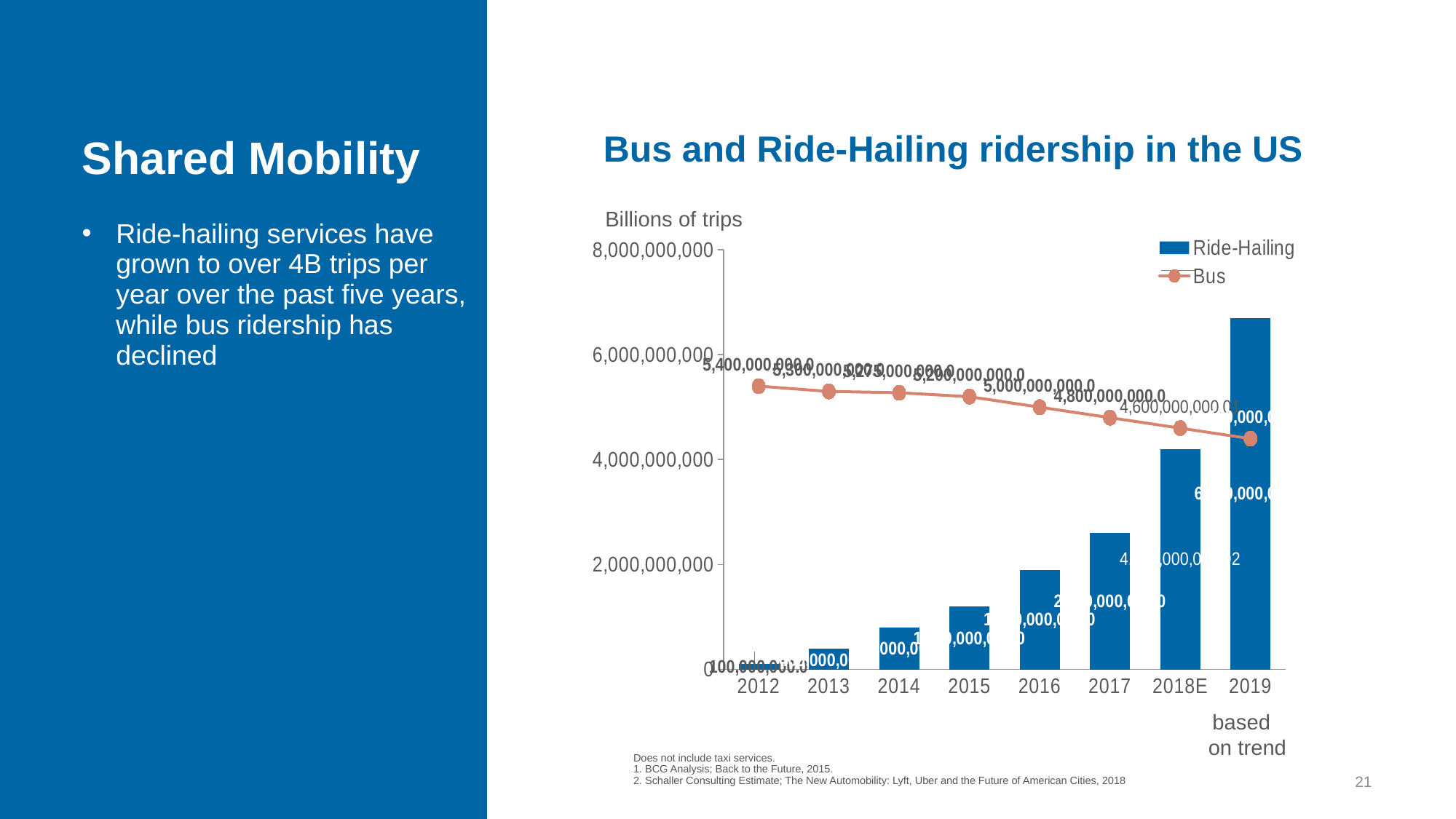
Which year has the highest Ride-Hailing value? 2019 Which year has the lowest Ride-Hailing value? 2012 Do the Bus values rise or fall from 2012 to 2019? fall What type of chart is shown on the slide? A combined bar and line chart What is the difference between the Bus values for 2016 and 2017? 200,000,000.0 What is the Bus value for 2012? 5,400,000,000.0 In 2016, which is larger: the Bus value or the Ride-Hailing value? Bus What is the Bus value for 2018E? 4,600,000,000.0 How many series does the legend list? 2 Is the Ride-Hailing value for 2019 greater or less than 6,000,000,000? greater How many years are shown on the x axis? 8 What is the Bus value for 2017? 4,800,000,000.0